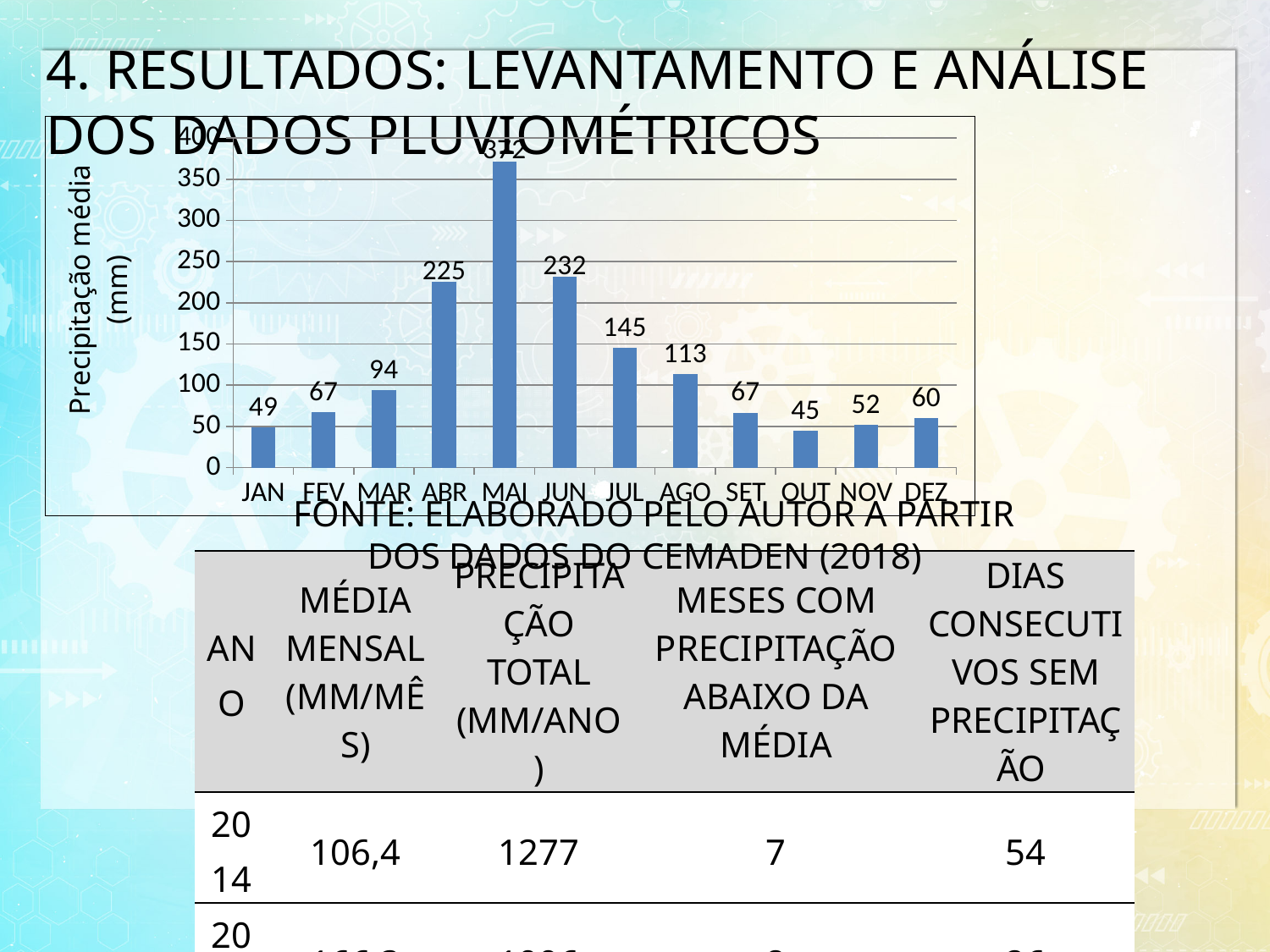
What is the average precipitation value for OUT? 45 Which month has the highest average precipitation? MAI What type of chart is shown on the slide? bar chart Which month has the lowest average precipitation? OUT How many months are shown on the x axis of the chart? 12 What is the difference between the values for JUN and ABR? 7 What is the difference between the values for JUL and AGO? 32 Which month has a larger value, MAR or AGO? AGO What is the average precipitation value for ABR? 225 What is the title of the vertical axis of the chart? Precipitação média (mm) Is the value for JUN greater or less than 200? greater What is the average precipitation value for JUL? 145